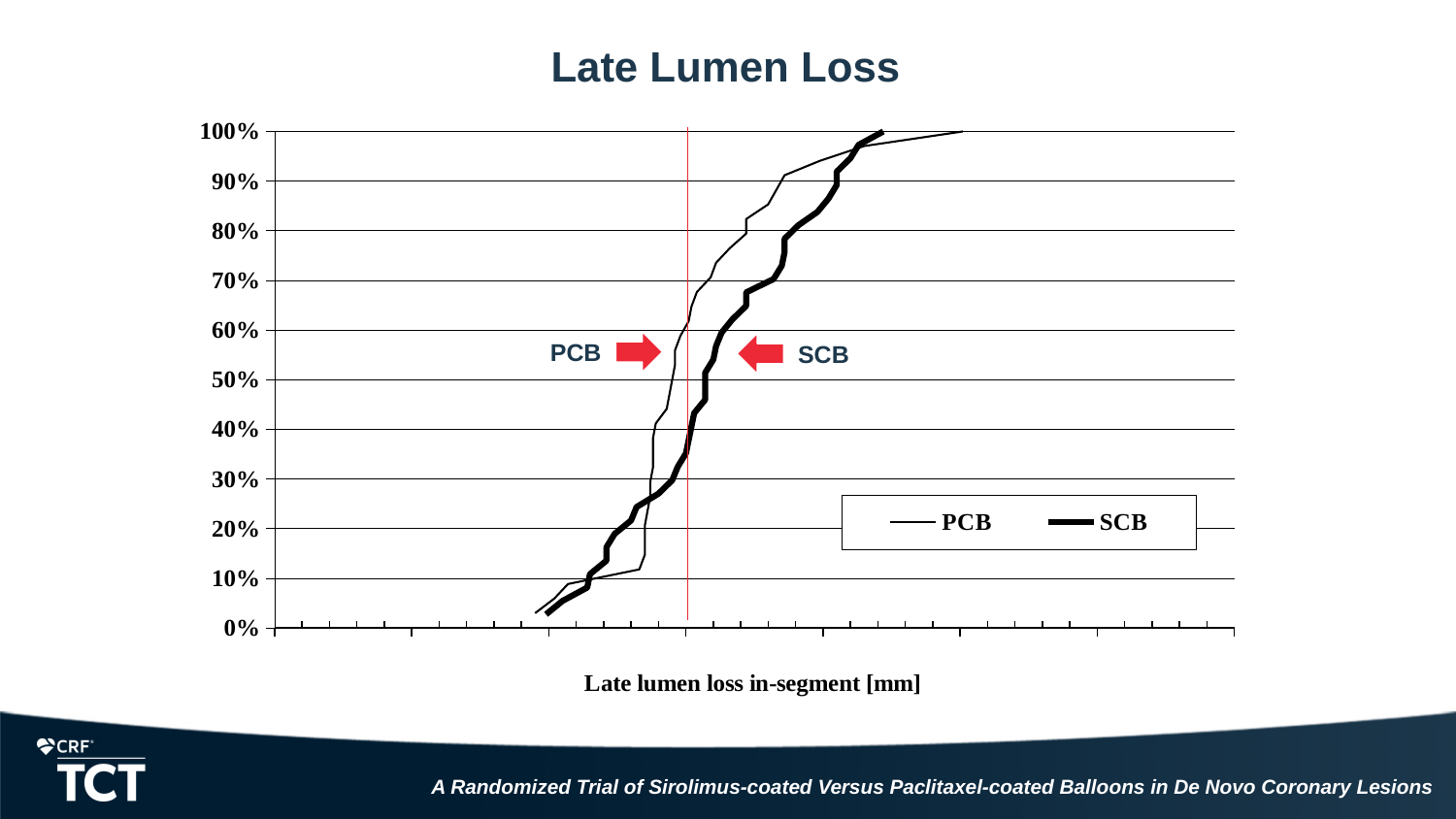
Do the values of the SCB series rise or fall along the x axis? rise How many percentage labels are shown on the y axis? 11 At the red vertical line, which series has the higher cumulative percentage, PCB or SCB? PCB What is the label of the x axis? Late lumen loss in-segment [mm] What kind of chart is shown on the slide? line chart Which series reaches 50% at a smaller late lumen loss value, PCB or SCB? PCB Which series reaches 100% at a larger late lumen loss value, PCB or SCB? PCB Do the values of the PCB series rise or fall along the x axis? rise What is the highest value labelled on the y axis? 100% What are the two series named in the legend? PCB and SCB How many series does the legend list? 2